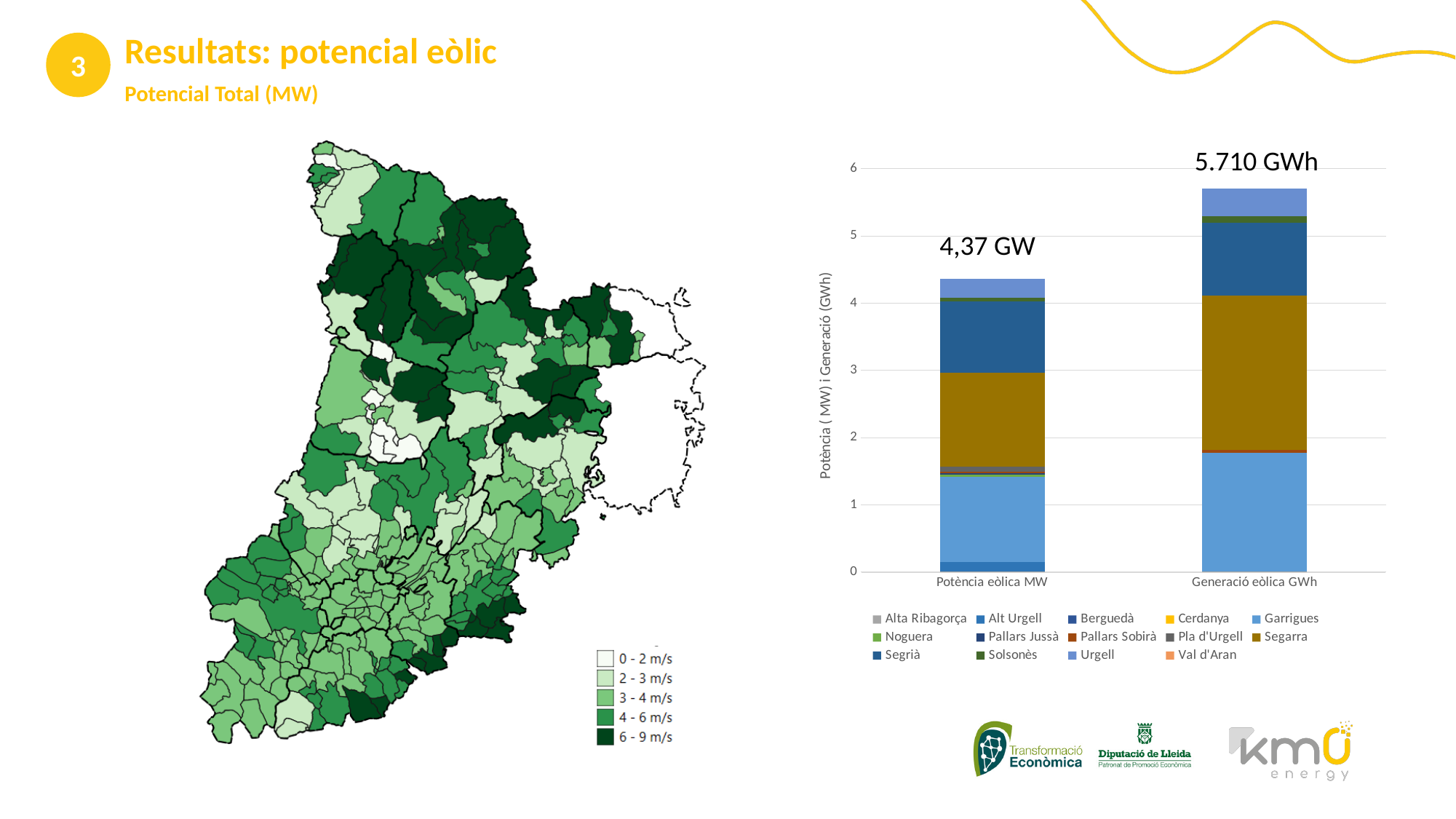
What is the highest tick value shown on the y axis of the stacked bar chart? 6 What is the y-axis label of the stacked bar chart? Potència ( MW) i Generació (GWh) How many bars (categories) does the stacked bar chart show? 2 Is the top of the 'Potència eòlica MW' bar greater or less than 5 on the y axis? less How many series does the legend of the stacked bar chart list? 14 Is the top of the 'Generació eòlica GWh' bar greater or less than 5 on the y axis? greater What kind of chart is shown on the right of the slide? Stacked bar chart What total value is labelled above the 'Potència eòlica MW' bar? 4,37 GW Is the top of the 'Potència eòlica MW' bar greater or less than 4 on the y axis? greater What total value is labelled above the 'Generació eòlica GWh' bar? 5.710 GWh Which bar is taller, 'Potència eòlica MW' or 'Generació eòlica GWh'? Generació eòlica GWh Which series forms the largest segment of the 'Generació eòlica GWh' bar? Segarra